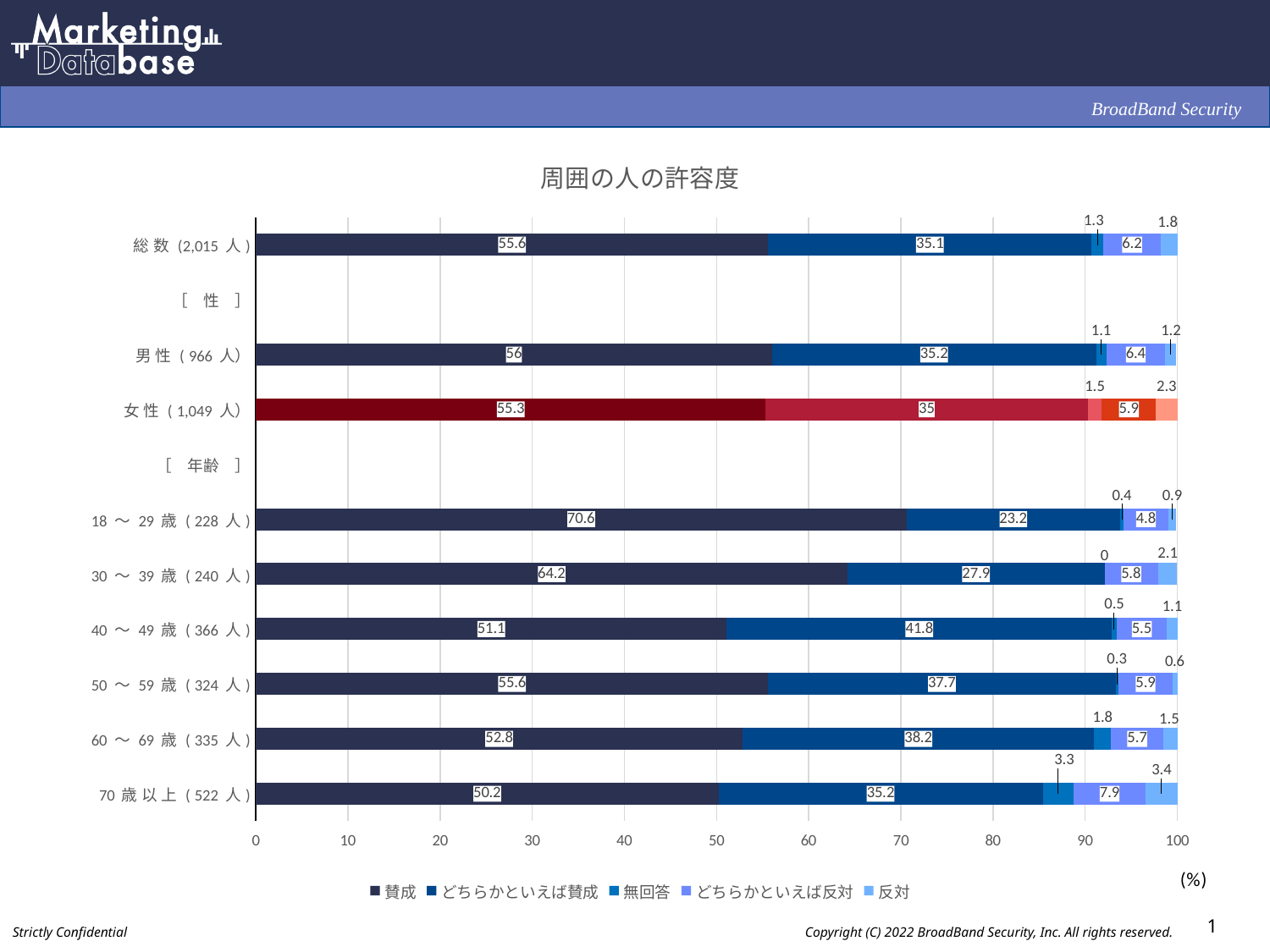
What is the どちらかといえば賛成 value for 40 〜 49 歳 (366 人)? 41.8 How many series does the legend list? 5 What kind of chart is shown on the slide? Stacked bar chart What is the 反対 value for 女 性 (1,049 人)? 2.3 What is the 無回答 value for 70 歳 以上 (522 人)? 3.3 What is the 賛成 value for 総数 (2,015 人)? 55.6 Which category has the highest 賛成 value? 18 〜 29 歳 (228 人) How many categories have data bars plotted in the chart? 9 What is the title of the chart? 周囲の人の許容度 What is the difference between the 賛成 values for 18 〜 29 歳 (228 人) and 30 〜 39 歳 (240 人)? 6.4 Which category has the lowest 賛成 value? 70 歳 以上 (522 人) Which is larger, the どちらかといえば反対 value for 70 歳 以上 (522 人) or for 60 〜 69 歳 (335 人)? 70 歳 以上 (522 人)